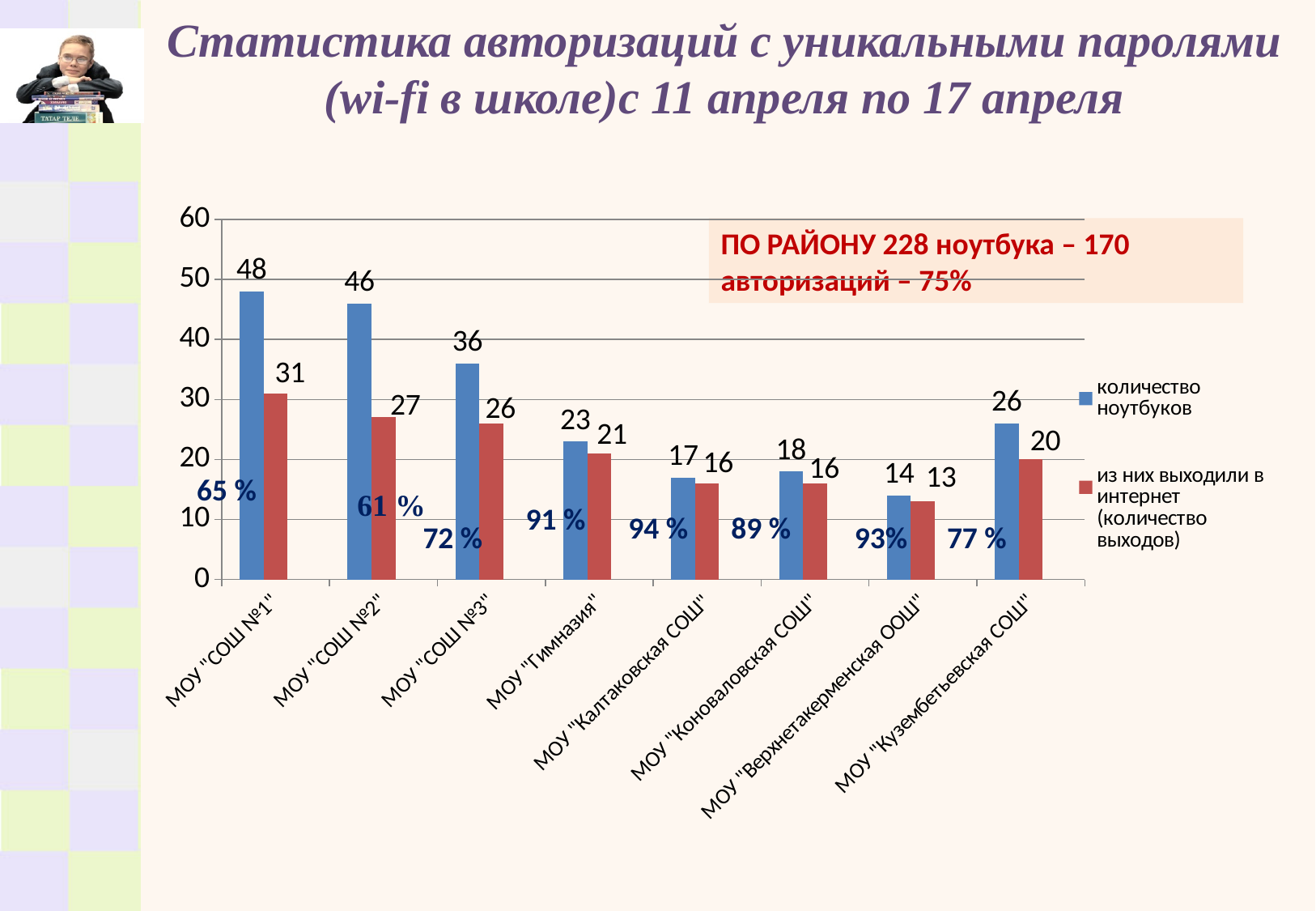
What is the value of "из них выходили в интернет" for МОУ "СОШ №2"? 27 Which school has the lowest value for "из них выходили в интернет"? МОУ "Верхнетакерменская ООШ" How many schools (categories) are shown on the x axis? 8 Which school has the highest value for "количество ноутбуков"? МОУ "СОШ №1" How many series does the legend list? 2 What is the difference between "количество ноутбуков" and "из них выходили в интернет" for МОУ "СОШ №3"? 10 What type of chart is shown on the slide? bar chart What is the value of "количество ноутбуков" for МОУ "СОШ №1"? 48 What colour are the bars for the series "количество ноутбуков"? blue Is the value of "количество ноутбуков" for МОУ "СОШ №2" greater or less than 40? greater What is the value of "количество ноутбуков" for МОУ "Кузембетьевская СОШ"? 26 Which is larger: "количество ноутбуков" for МОУ "Гимназия" or for МОУ "Коноваловская СОШ"? МОУ "Гимназия"